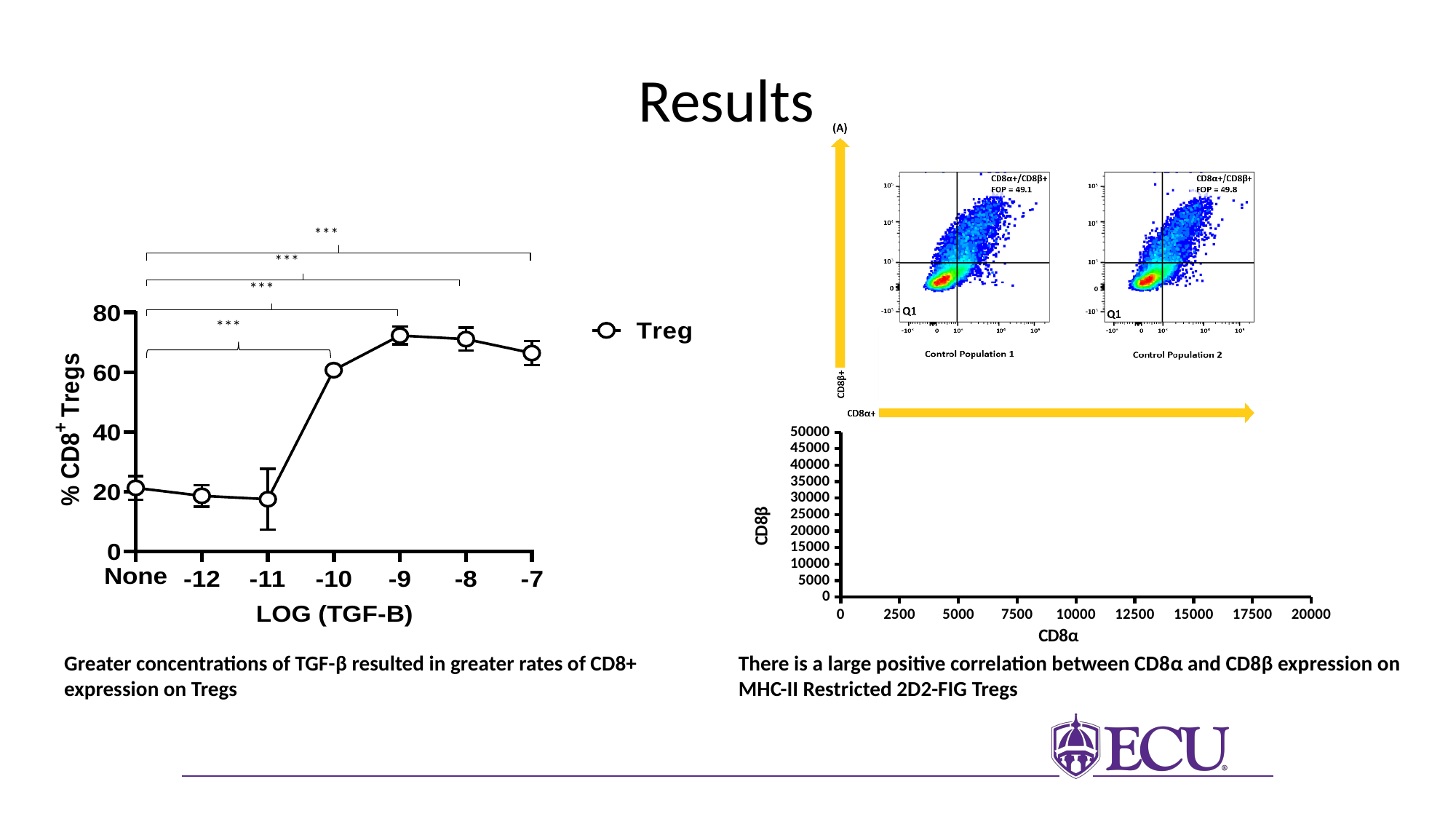
On the right chart with axes CD8β and CD8α, what is the highest tick shown on the x axis? 20000 On the left chart, how many series does the legend list? 1 On the left chart, how many points are plotted along the LOG (TGF-B) axis? 7 On the left chart, what is the name of the series in the legend? Treg On the left chart, what is the x-axis title? LOG (TGF-B) On the left chart, is the value for -9 greater or less than 60? greater On the left chart, which has the larger value, -9 or None? -9 On the left chart, is the value for -10 greater or less than 40? greater What kind of chart is the left chart showing % CD8+ Tregs against LOG (TGF-B)? line chart On the left chart, do the values rise or fall from -11 to -9? rise On the left chart, is the value for None greater or less than 40? less